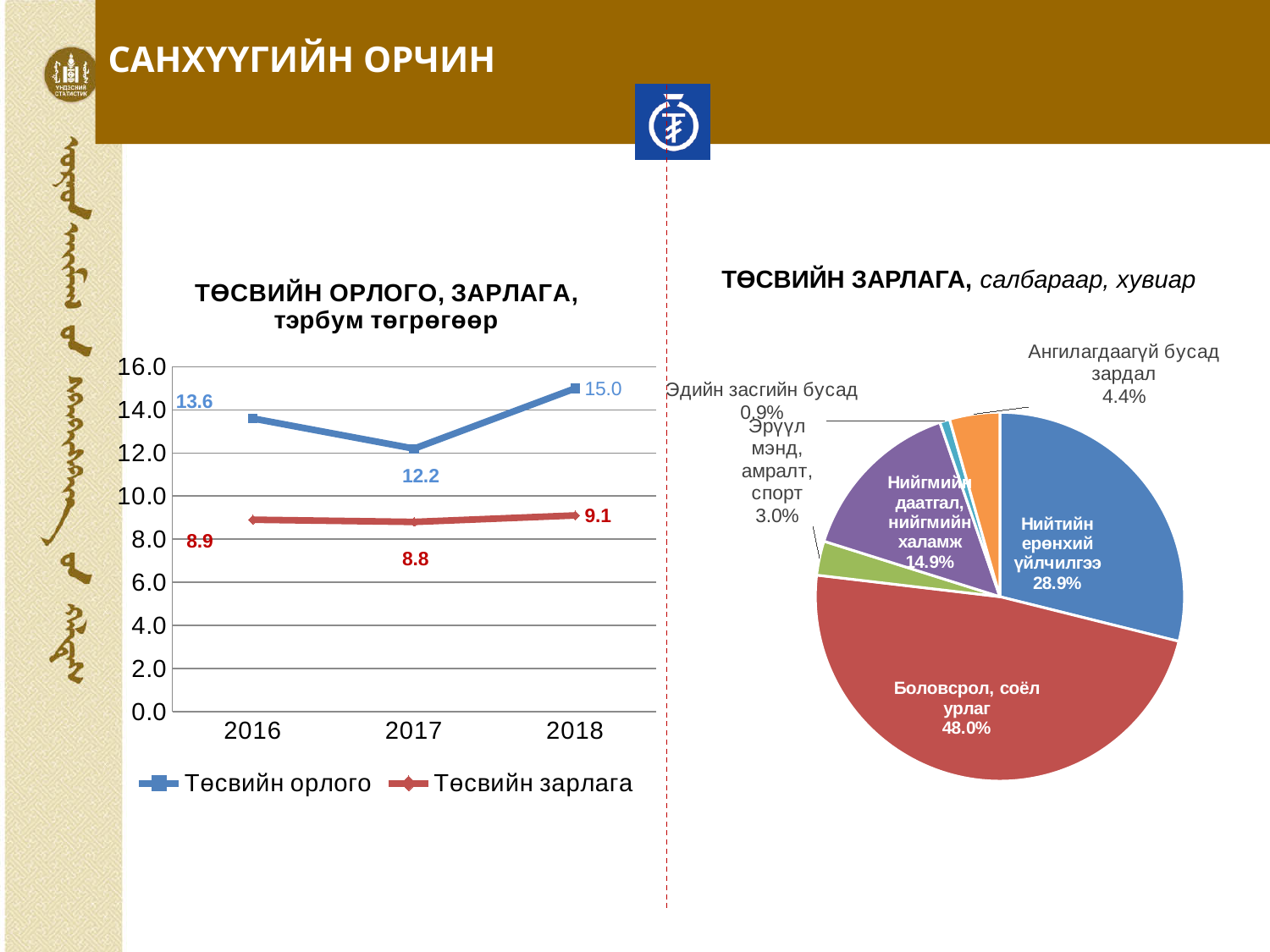
In the line chart 'ТӨСВИЙН ОРЛОГО, ЗАРЛАГА', what is the value of Төсвийн орлого in 2018? 15.0 What kind of chart is the chart on the left of the slide? Line chart In the line chart 'ТӨСВИЙН ОРЛОГО, ЗАРЛАГА', what is the value of Төсвийн зарлага in 2017? 8.8 In the line chart 'ТӨСВИЙН ОРЛОГО, ЗАРЛАГА', how many years are shown on the x axis? 3 In the pie chart 'ТӨСВИЙН ЗАРЛАГА, салбараар, хувиар', which category has the smallest share? Эдийн засгийн бусад What kind of chart is the chart on the right of the slide? Pie chart In the pie chart 'ТӨСВИЙН ЗАРЛАГА, салбараар, хувиар', what share does Боловсрол, соёл урлаг have? 48.0% In the line chart 'ТӨСВИЙН ОРЛОГО, ЗАРЛАГА', what is the difference between Төсвийн орлого and Төсвийн зарлага in 2016? 4.7 In the line chart 'ТӨСВИЙН ОРЛОГО, ЗАРЛАГА', which is larger in 2018: Төсвийн орлого or Төсвийн зарлага? Төсвийн орлого In the pie chart 'ТӨСВИЙН ЗАРЛАГА, салбараар, хувиар', what is the share of Нийгмийн даатгал, нийгмийн халамж? 14.9% In the line chart 'ТӨСВИЙН ОРЛОГО, ЗАРЛАГА', how many series does the legend list? 2 In the line chart 'ТӨСВИЙН ОРЛОГО, ЗАРЛАГА', in which year is Төсвийн орлого lowest? 2017